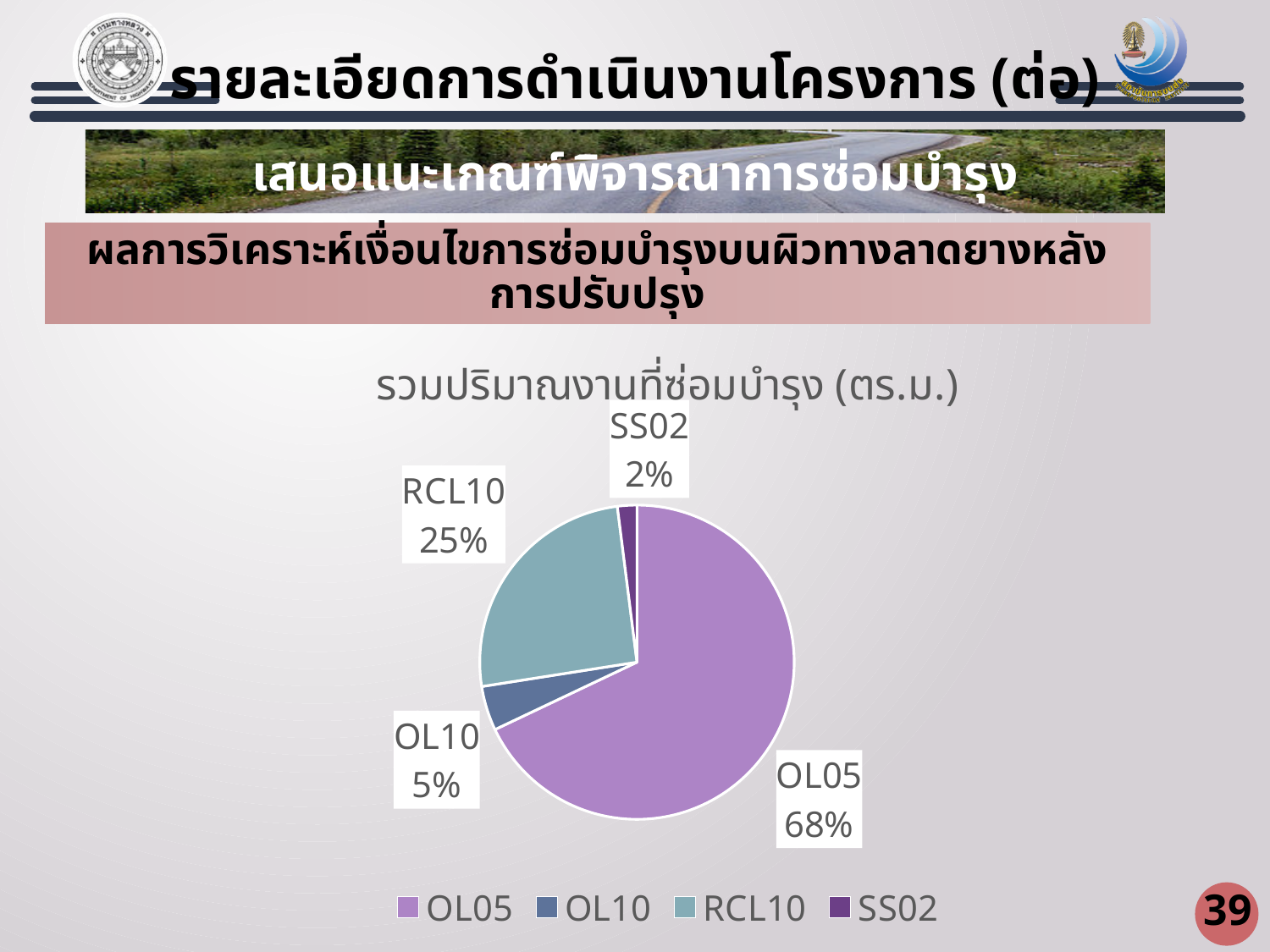
What is the difference in percentage points between OL05 and RCL10? 43% What share of the pie does OL05 have? 68% What share of the pie does RCL10 have? 25% What share of the pie does OL10 have? 5% How many categories does the pie chart have? 4 Which category has the smallest slice of the pie? SS02 How many entries does the legend list? 4 What kind of chart is shown on the slide? pie chart What is the title of the pie chart? รวมปริมาณงานที่ซ่อมบำรุง (ตร.ม.) Which is larger, the share for OL10 or the share for RCL10? RCL10 Which category has the largest slice of the pie? OL05